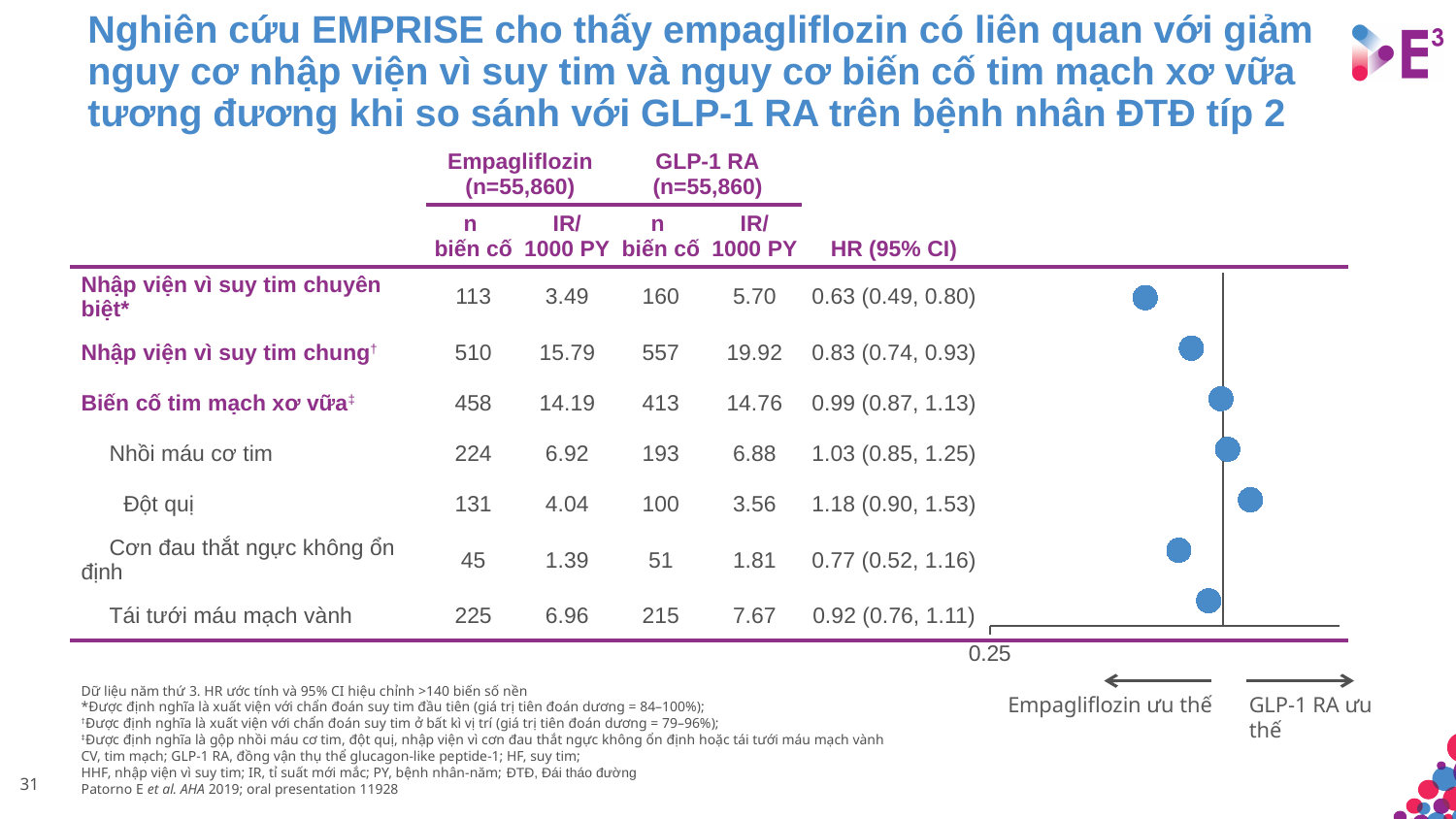
Which has the larger hazard ratio: 'Nhập viện vì suy tim chung' or 'Biến cố tim mạch xơ vữa'? Biến cố tim mạch xơ vữa What is the hazard ratio (95% CI) for 'Nhập viện vì suy tim chuyên biệt*'? 0.63 (0.49, 0.80) According to the arrows under the plot, which treatment is favoured on the left side of the axis? Empagliflozin What is the IR/1000 PY for GLP-1 RA in the 'Nhập viện vì suy tim chung' row? 19.92 What is the hazard ratio (95% CI) for 'Nhồi máu cơ tim'? 1.03 (0.85, 1.25) Which outcome has the highest hazard ratio in the forest plot? Đột quị What kind of chart is shown on the slide? Forest plot How many events (n biến cố) were there for empagliflozin in the 'Đột quị' row? 131 What is the difference in IR/1000 PY between GLP-1 RA and empagliflozin for 'Nhập viện vì suy tim chuyên biệt*'? 2.21 What is the difference between the hazard ratio for 'Đột quị' and the hazard ratio for 'Nhập viện vì suy tim chuyên biệt*'? 0.55 How many outcomes are plotted in the forest plot? 7 Which outcome has the lowest hazard ratio in the forest plot? Nhập viện vì suy tim chuyên biệt*